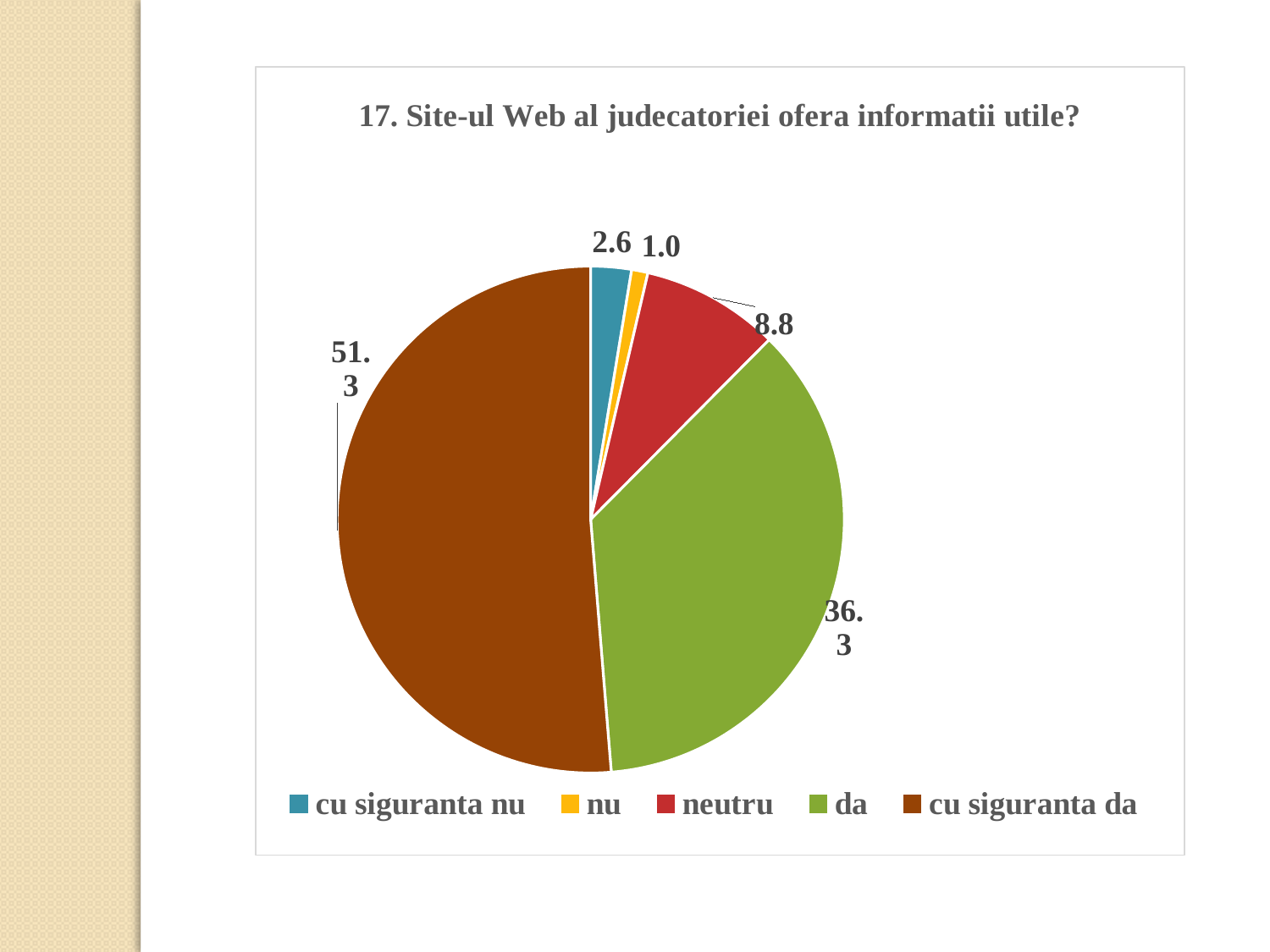
Which category has the largest slice? cu siguranta da What is the value for the "nu" slice? 1.0 What is the difference between the values for "cu siguranta da" and "da"? 15.0 What type of chart is shown on the slide? pie chart How many slices does the pie chart have? 5 Which is larger, the value for "neutru" or the value for "cu siguranta nu"? neutru What is the value for the "neutru" slice? 8.8 What is the value for the "cu siguranta da" slice? 51.3 Which category has the smallest slice? nu What is the value for the "da" slice? 36.3 What is the value for the "cu siguranta nu" slice? 2.6 What is the title of the chart? 17. Site-ul Web al judecatoriei ofera informatii utile?